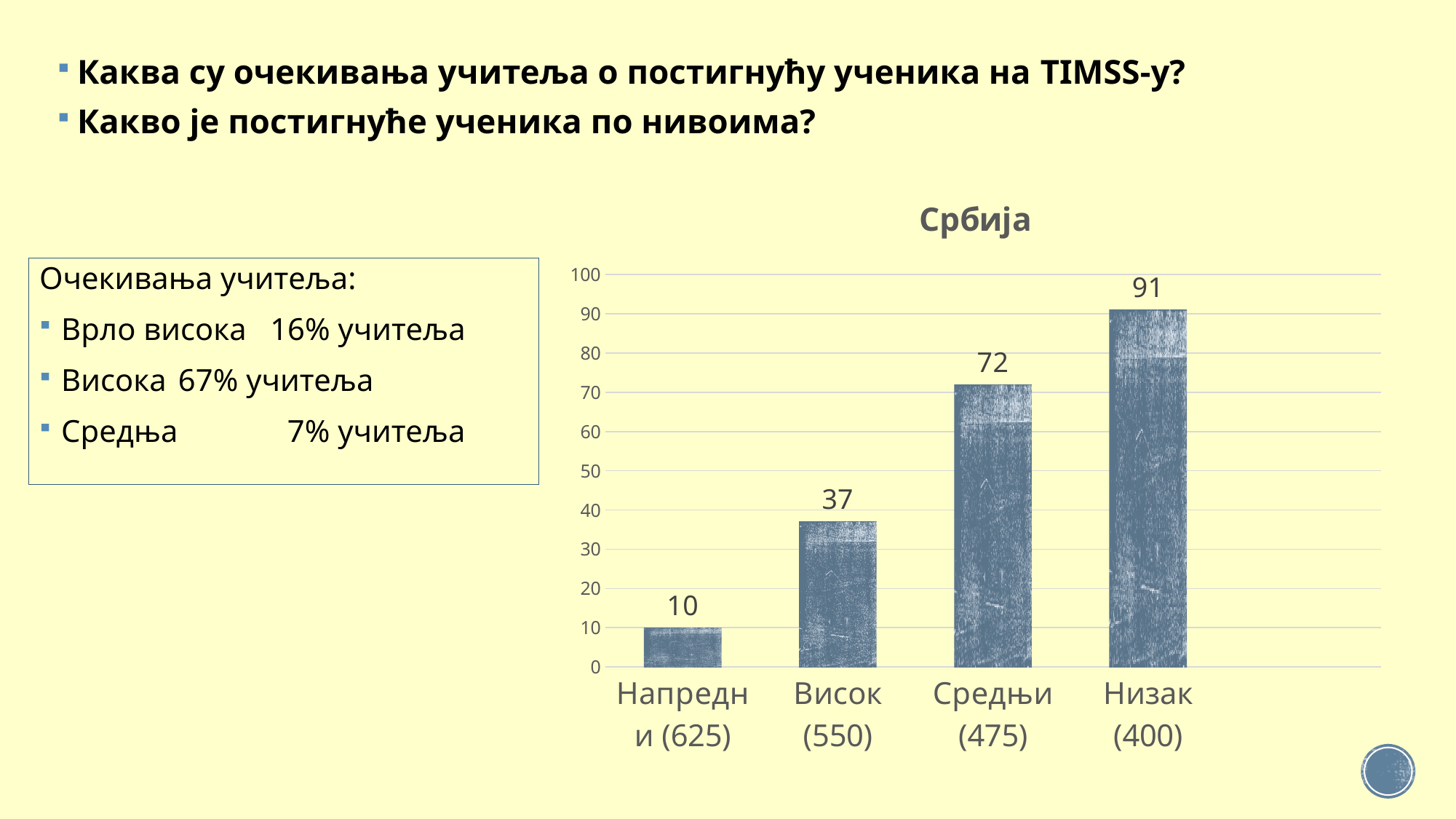
Which category has the lowest value in the chart? Напредни (625) What kind of chart is shown on the slide? bar chart What is the title of the chart? Србија What is the value for Средњи (475) in the chart? 72 What is the value for Напредни (625) in the chart? 10 What is the value for Низак (400) in the chart? 91 What is the difference between the values for Низак (400) and Средњи (475)? 19 How many categories are shown in the chart? 4 What is the value for Висок (550) in the chart? 37 Which is larger, the value for Средњи (475) or the value for Висок (550)? Средњи (475) Which category has the highest value in the chart? Низак (400) What is the difference between the values for Висок (550) and Напредни (625)? 27